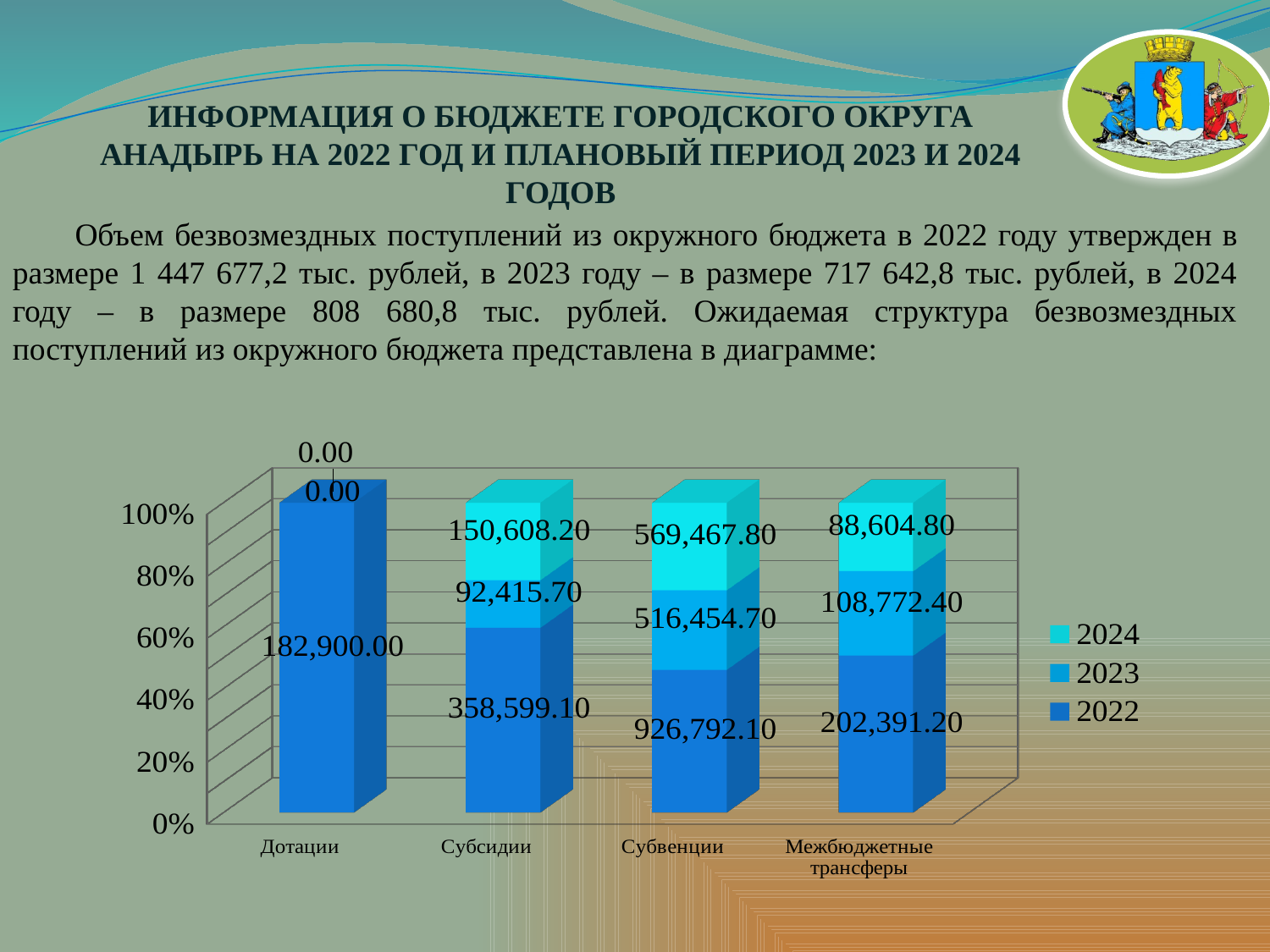
How many categories are shown on the x axis? 4 Which category has the lowest 2024 value? Дотации What is the difference between the 2022 and 2023 values for Субвенции? 410,337.40 What is the 2023 value for Межбюджетные трансферы? 108,772.40 How many series does the legend list? 3 What is the 2023 value for Дотации? 0.00 What is the total of the three values in the Межбюджетные трансферы bar? 399,768.40 What is the 2022 value for Субвенции? 926,792.10 What is the 2024 value for Субсидии? 150,608.20 What kind of chart is shown on the slide? Stacked bar chart Which is larger for Межбюджетные трансферы: the 2023 value or the 2024 value? 2023 Which category has the highest 2022 value? Субвенции